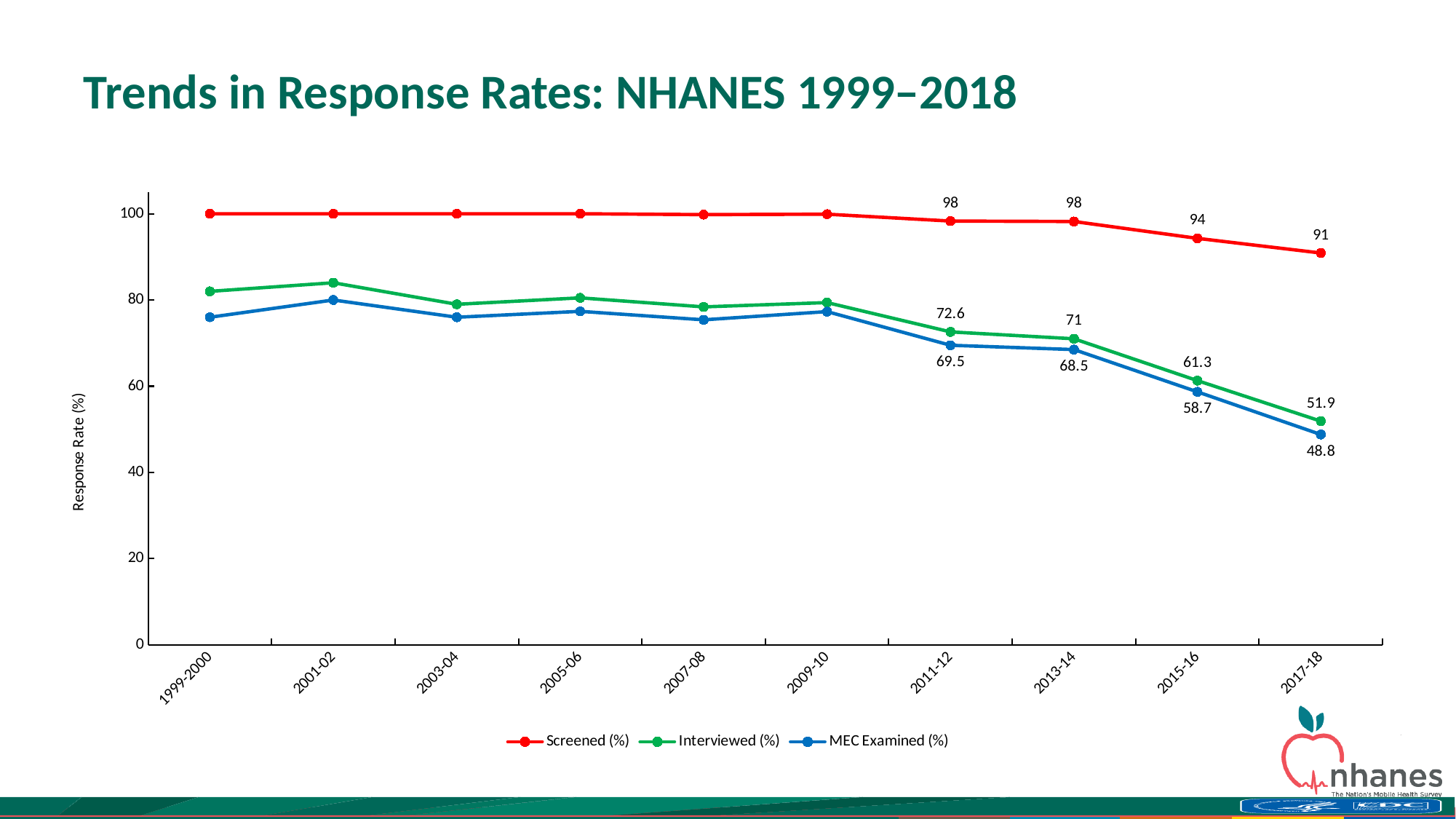
Is the Interviewed (%) value for 2001-02 greater or less than 80? greater How many survey cycles are plotted along the x axis? 10 What is the difference between the Interviewed (%) and MEC Examined (%) values in 2011-12? 3.1 How many series does the legend list? 3 What is the Interviewed (%) value for 2017-18? 51.9 What is the Screened (%) value for 2013-14? 98 Which series has the lowest value in 2017-18? MEC Examined (%) What is the MEC Examined (%) value for 2015-16? 58.7 Does the MEC Examined (%) series rise or fall from 2009-10 to 2017-18? fall What type of chart is shown on the slide? line chart By how much did the Screened (%) value fall from 2015-16 to 2017-18? 3 What is the title of the chart? Trends in Response Rates: NHANES 1999–2018